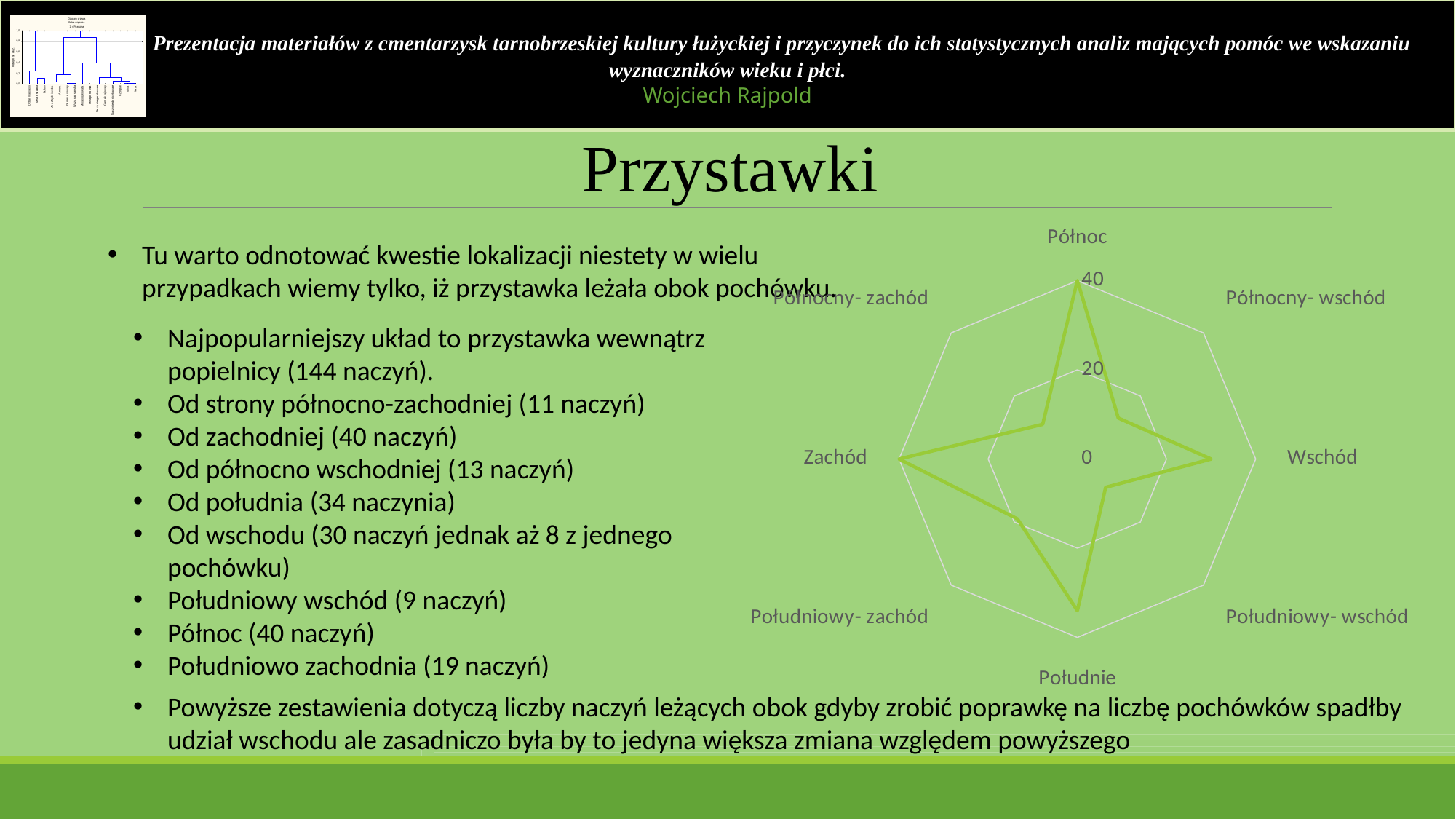
What is the value for Północ on the radar chart? 40 Is the value for Wschód greater or less than 20? greater Is the value for Południowy- wschód greater or less than 20? less Which has the larger value on the radar chart, Zachód or Wschód? Zachód Is the value for Północny- wschód greater or less than 20? less How many categories (directions) does the radar chart have? 8 What kind of chart is shown on the slide? radar chart What is the value for Zachód on the radar chart? 40 Which has the larger value on the radar chart, Południe or Południowy- wschód? Południe What is the highest tick value shown on the radar chart's axis? 40